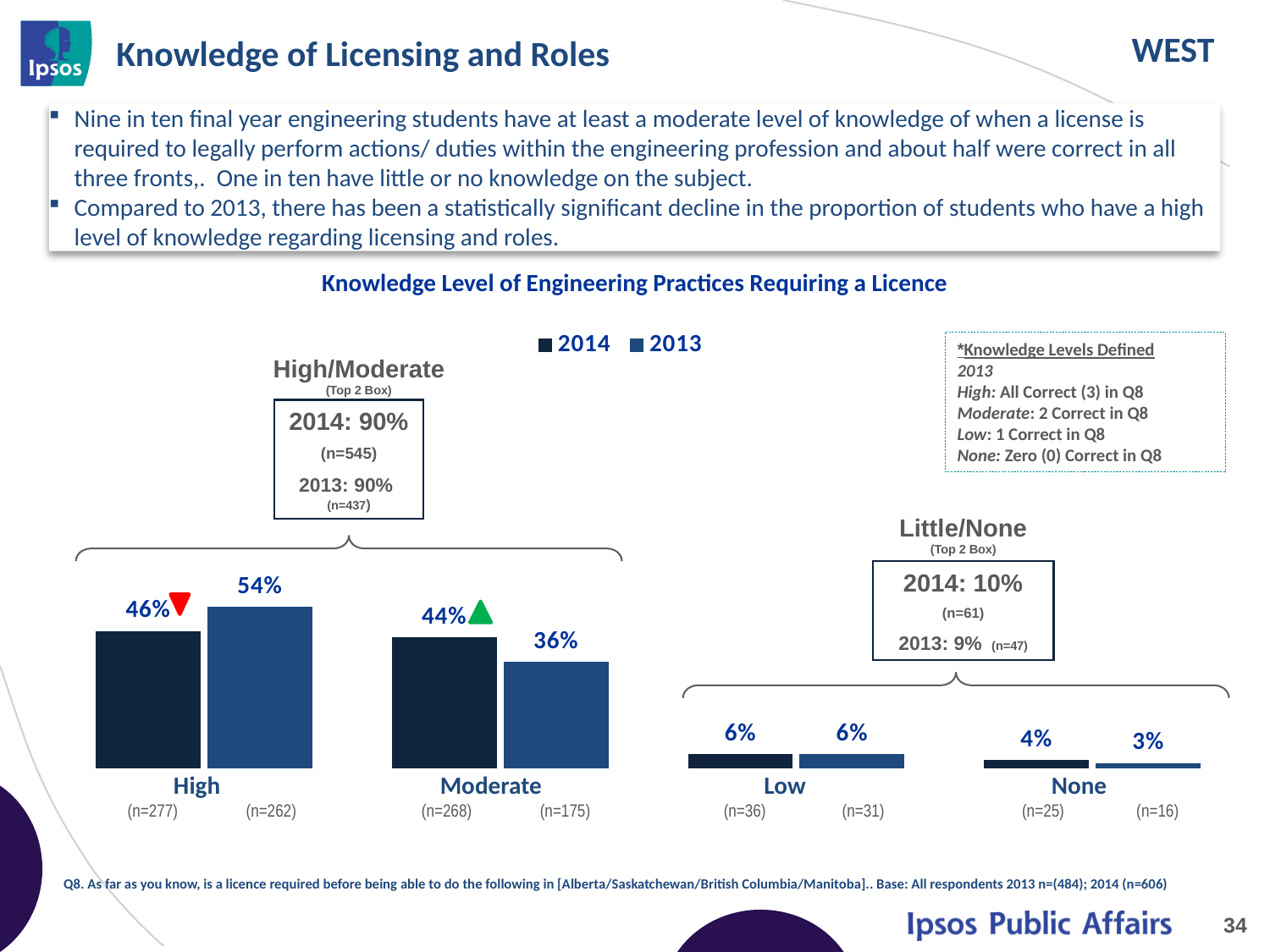
Which is larger for the Moderate knowledge level, the 2014 value or the 2013 value? 2014 What is the 2014 value for the High knowledge level? 46% What is the 2013 value for the Moderate knowledge level? 36% What is the 2013 value for the None knowledge level? 3% How many series does the chart legend list? 2 What is the difference between the 2014 and 2013 values for the Moderate knowledge level? 8% What kind of chart is used to show the knowledge levels? Bar chart Which knowledge level has the lowest 2014 value? None What is the difference between the 2013 and 2014 values for the High knowledge level? 8% Which knowledge level has the highest 2013 value? High What is the title of the chart? Knowledge Level of Engineering Practices Requiring a Licence How many knowledge level categories are shown on the x axis of the chart? 4